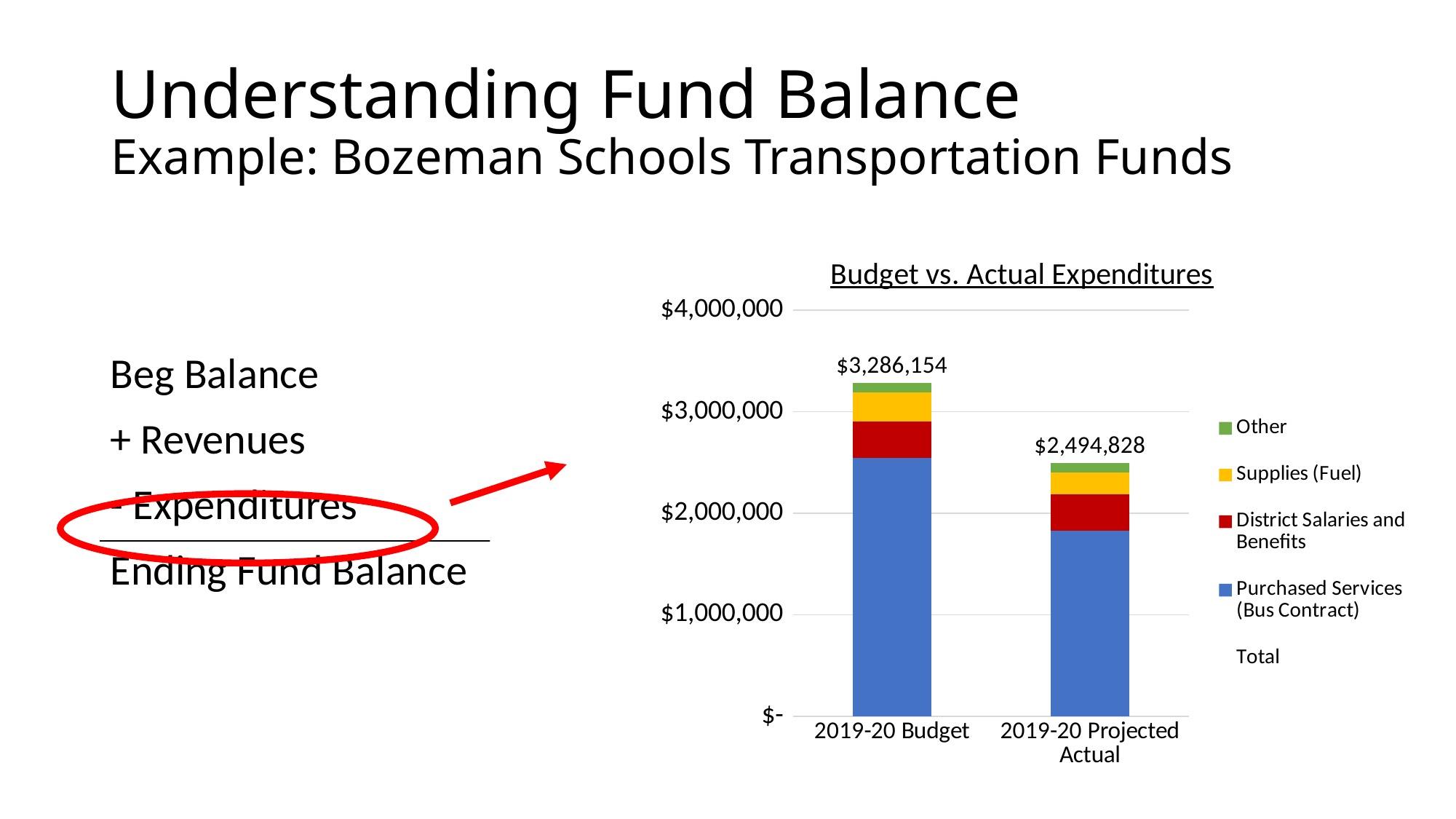
How many bars (categories) are shown on the x axis? 2 Which category has the higher total expenditures? 2019-20 Budget Is the 2019-20 Budget total larger or smaller than the 2019-20 Projected Actual total? larger What is the total labelled on the 2019-20 Budget bar? $3,286,154 What kind of chart is shown? stacked bar chart Is the Purchased Services (Bus Contract) value for 2019-20 Budget greater or less than $2,000,000? greater What is the difference between the 2019-20 Budget total and the 2019-20 Projected Actual total? $791,326 What is the title of the chart? Budget vs. Actual Expenditures How many entries does the legend list? 5 Is the Purchased Services (Bus Contract) value for 2019-20 Projected Actual greater or less than $2,000,000? less What is the total labelled on the 2019-20 Projected Actual bar? $2,494,828 Which category has the lower total expenditures? 2019-20 Projected Actual